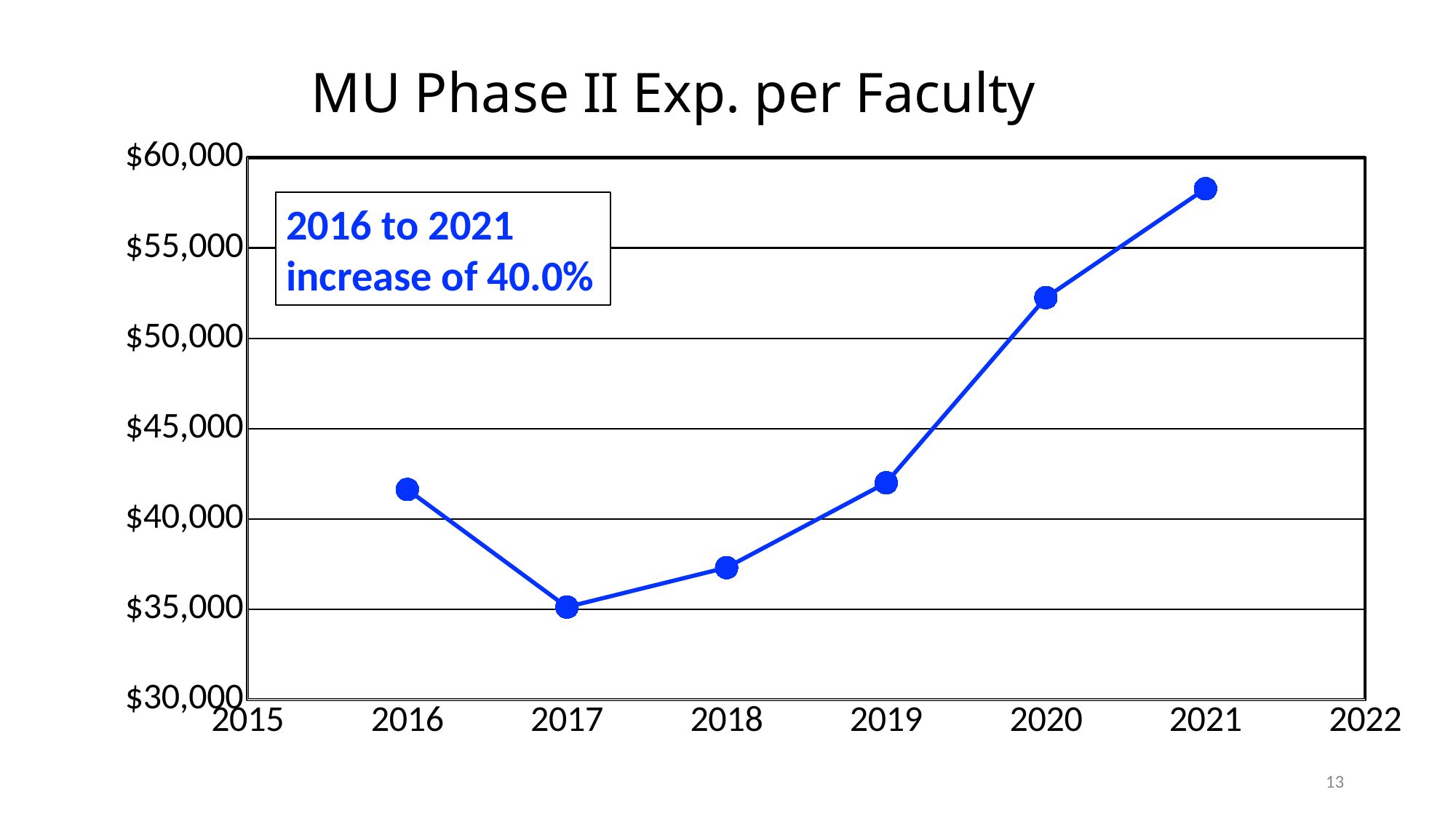
How many data points are plotted on the line? 6 What is the title of the chart? MU Phase II Exp. per Faculty Which year has the lowest expenditure per faculty? 2017 Do the values rise or fall from 2017 to 2021? rise Which year has a higher value, 2016 or 2019? 2019 Which year has the highest expenditure per faculty? 2021 Is the value for 2018 greater or less than $40,000? less Is the value for 2021 greater or less than $55,000? greater Is the value for 2016 greater or less than $40,000? greater What kind of chart is shown on the slide? line chart According to the annotation on the chart, what was the percentage increase from 2016 to 2021? 40.0%